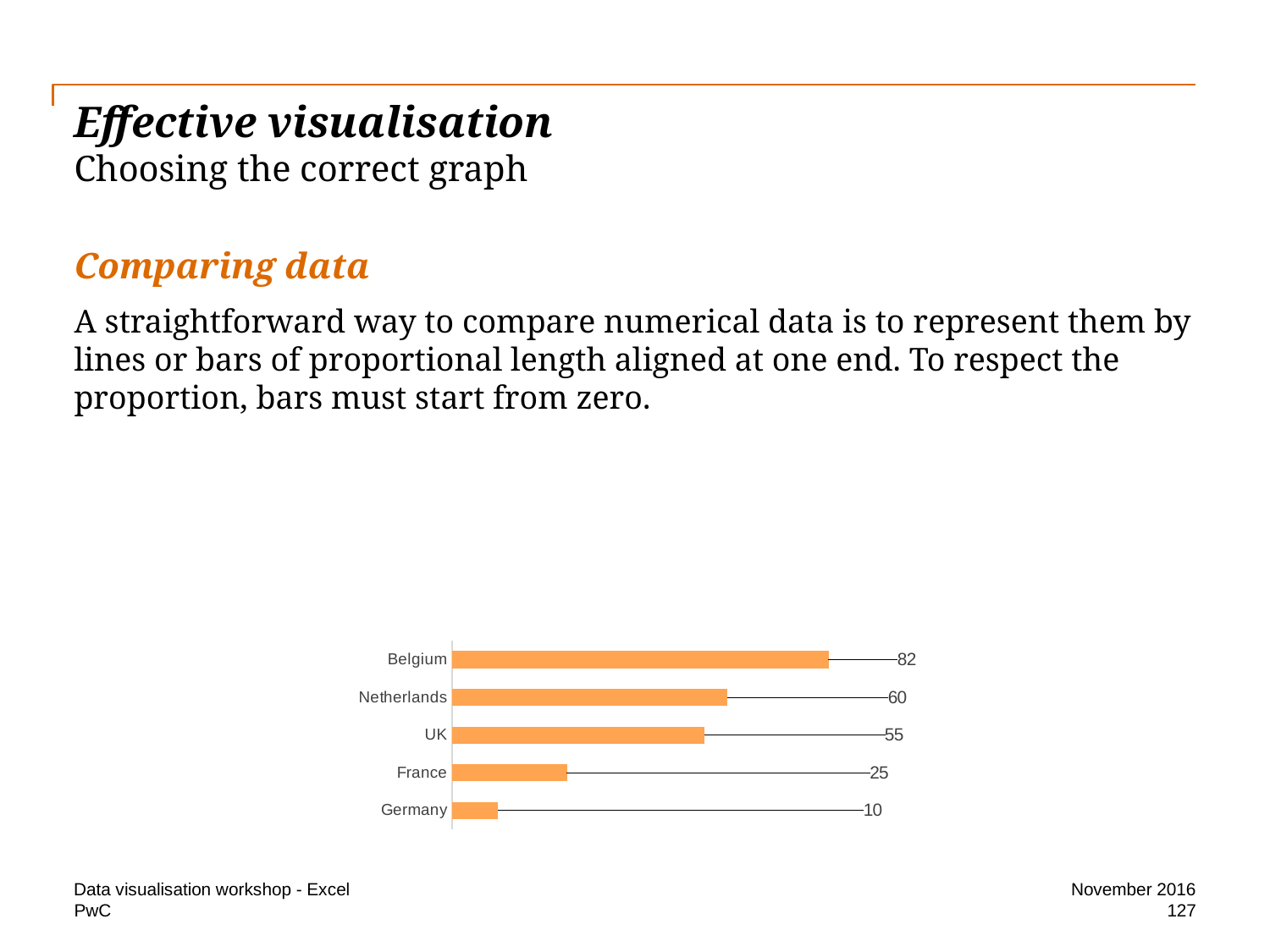
What kind of chart is shown on the slide? Bar chart What is the difference between the values for France and Germany? 15 Which has a larger value, Netherlands or UK? Netherlands What is the value for Netherlands? 60 What is the difference between the values for Belgium and Netherlands? 22 How many countries are shown in the chart? 5 Which country has the highest value? Belgium What is the value for UK? 55 What is the value for Germany? 10 What is the value for Belgium? 82 What is the value for France? 25 Which country has the lowest value? Germany